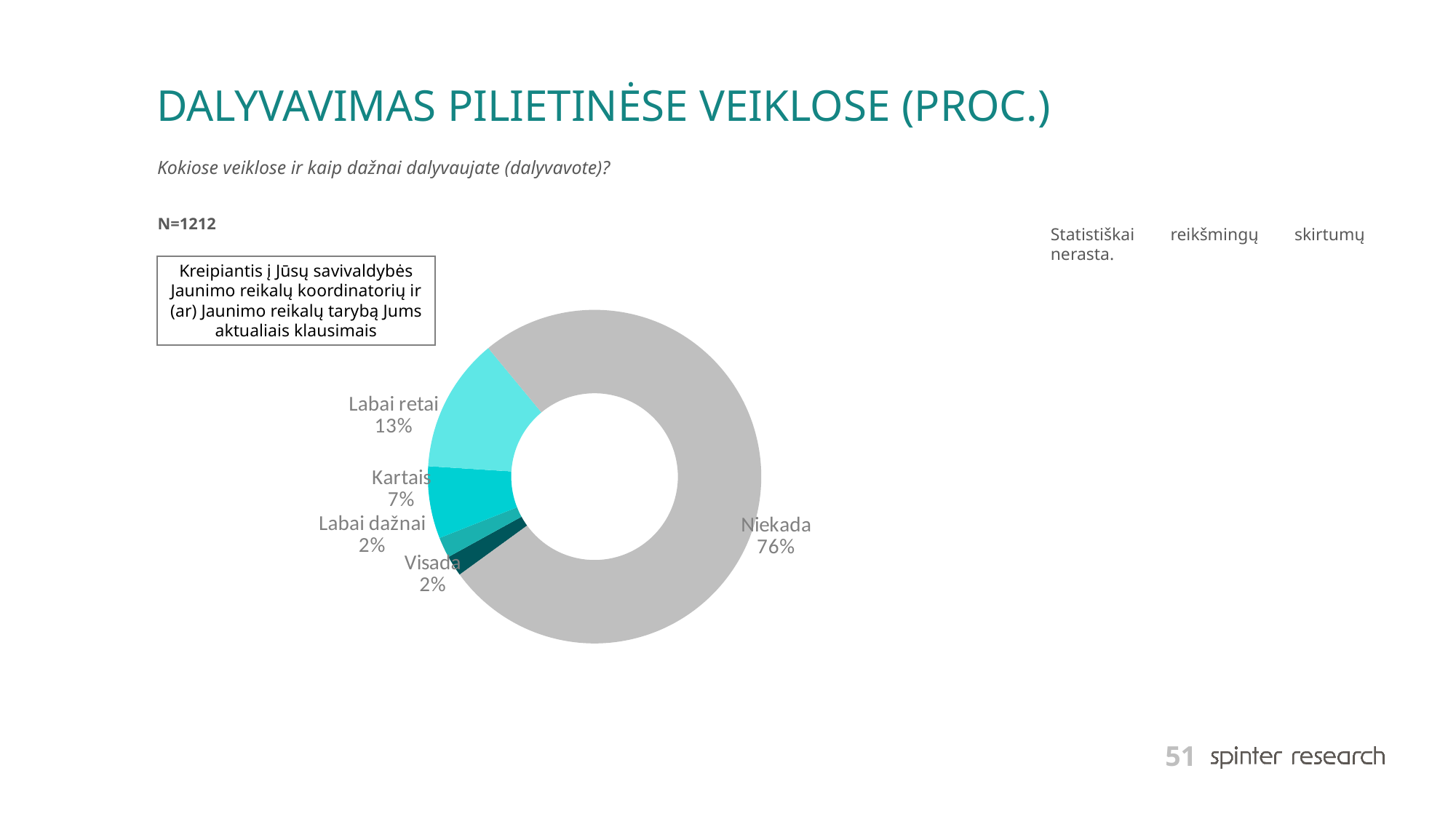
Which category has the largest share of the pie? Niekada How many categories are shown in the chart? 5 What share of respondents answered "Labai retai"? 13% What colour is the "Niekada" slice? Grey Which is larger, the share for "Kartais" or the share for "Labai dažnai"? Kartais What kind of chart is shown on the slide? Pie chart (doughnut) What is the sample size (N) stated on the slide? N=1212 What is the difference in percentage points between "Labai retai" and "Kartais"? 6 What share of respondents answered "Niekada"? 76% What share of respondents answered "Visada"? 2% What is the difference in percentage points between "Niekada" and "Labai retai"? 63 What share of respondents answered "Kartais"? 7%